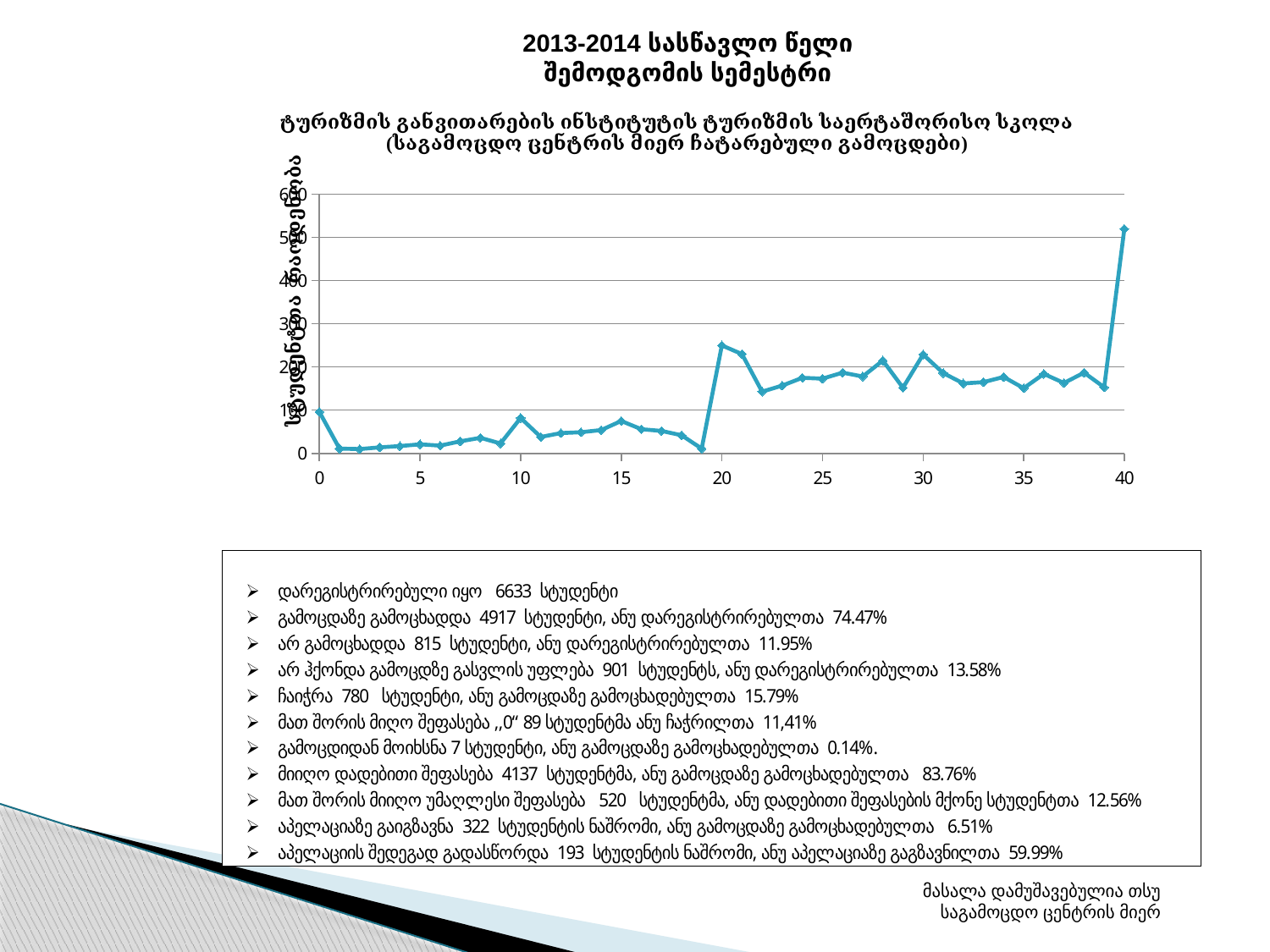
Which is larger, the value at x = 5 or the value at x = 25? x = 25 What is the highest tick value shown on the y axis? 600 Is the value at x = 25 greater or less than 100? greater Does the line rise or fall between x = 39 and x = 40? rise What is the highest tick value shown on the x axis? 40 Is the value at x = 20 greater or less than 200? greater Is the value at x = 40 greater or less than 400? greater Which is larger, the value at x = 20 or the value at x = 10? x = 20 At which x-axis position does the line reach its highest value? 40 What kind of chart is shown on the slide? line chart